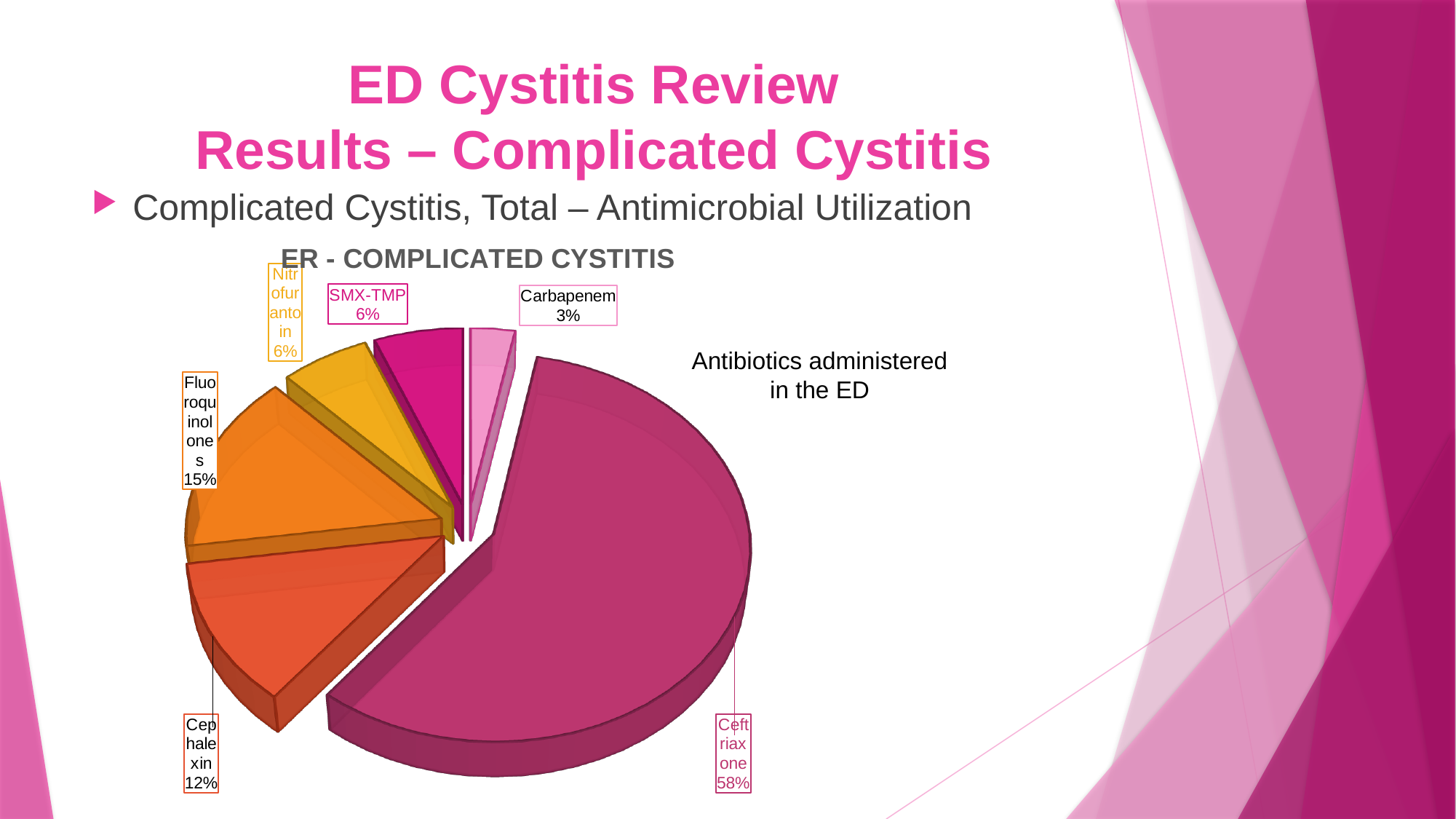
What is the chart's title? ER - COMPLICATED CYSTITIS What share of the pie does Ceftriaxone represent? 58% What share of the pie does Carbapenem represent? 3% Which has a larger share, Cephalexin or Nitrofurantoin? Cephalexin What share of the pie does Cephalexin represent? 12% What is the difference in percentage points between Ceftriaxone and Fluoroquinolones? 43 What type of chart is shown on the slide? Pie chart Which antibiotic has the smallest share of the pie? Carbapenem What share of the pie does SMX-TMP represent? 6% How many slices does the pie chart have? 6 Which antibiotic has the largest share of the pie? Ceftriaxone What share of the pie does Fluoroquinolones represent? 15%